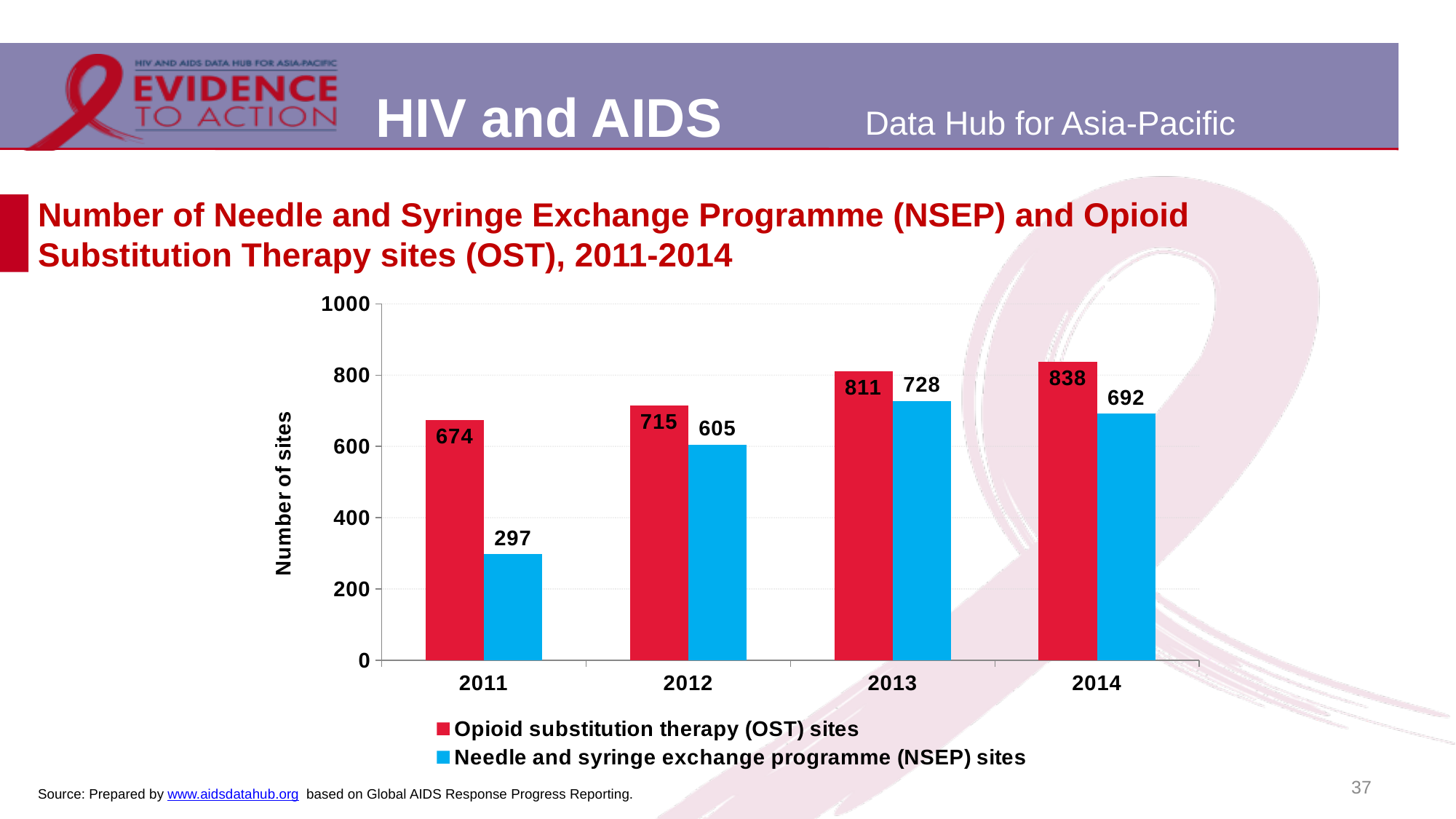
What kind of chart is shown on the slide? Bar chart Is the number of OST sites in 2013 greater or less than 800? greater Which was larger in 2014, the number of OST sites or the number of NSEP sites? OST sites By how much did the number of NSEP sites increase from 2011 to 2012? 308 In which year was the number of OST sites highest? 2014 What is the difference between OST sites and NSEP sites in 2011? 377 How many years are shown on the x axis? 4 How many series does the legend list? 2 What is the value for NSEP sites in 2014? 692 How many Opioid substitution therapy (OST) sites were there in 2011? 674 How many Needle and syringe exchange programme (NSEP) sites were there in 2013? 728 In which year was the number of NSEP sites lowest? 2011